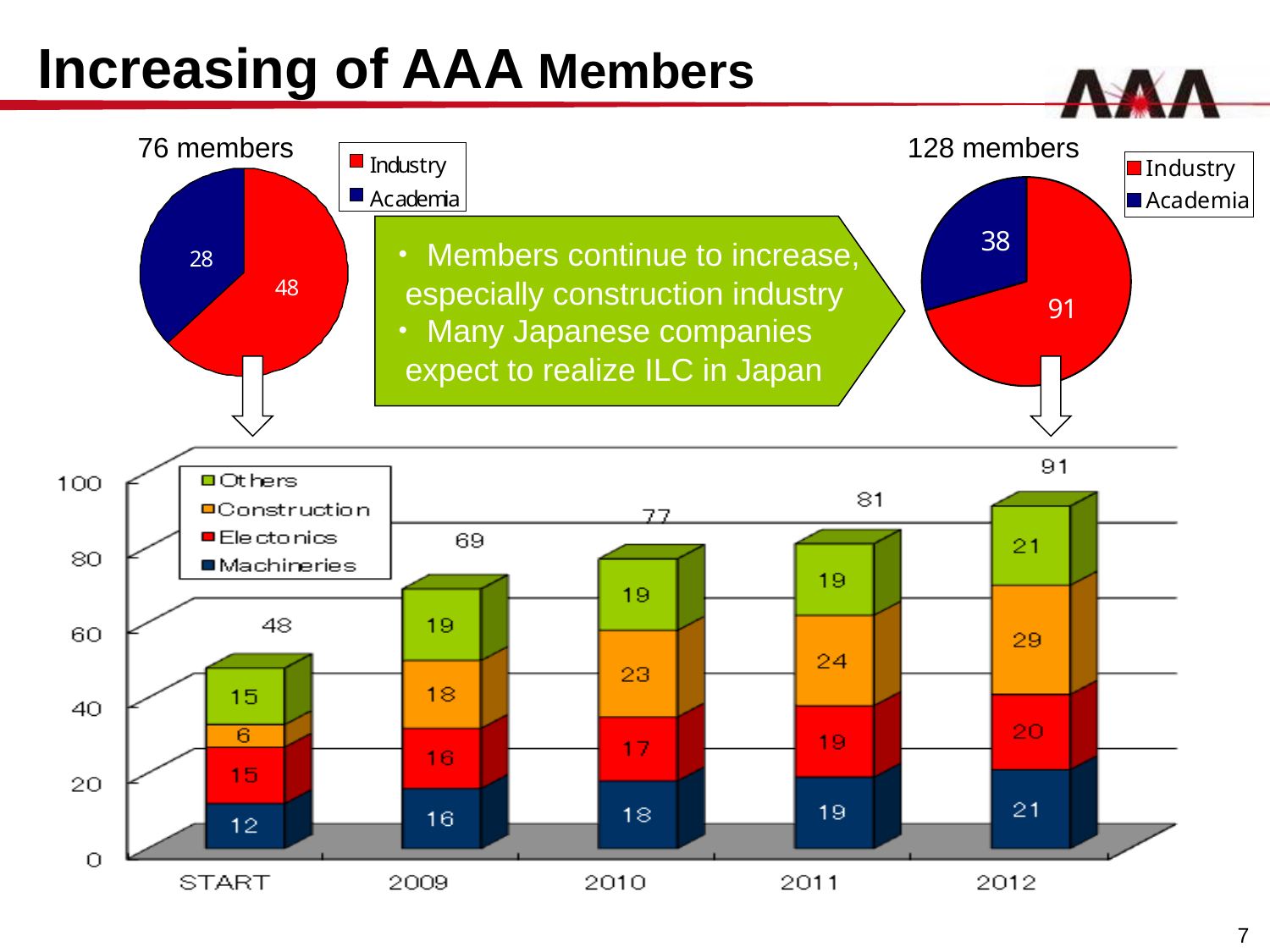
In the bottom stacked bar chart, how many series does the legend list? 4 In the bottom stacked bar chart, how many categories are shown on the x axis? 5 In the bottom stacked bar chart, which year has the highest total? 2012 In the bottom stacked bar chart, what is the total for 2012? 91 In the bottom stacked bar chart, do the totals rise or fall from START to 2012? rise In the '128 members' pie chart on the right, what is the value for Industry? 91 In the bottom stacked bar chart, what is the difference between the Construction values for 2012 and START? 23 In the bottom stacked bar chart, what is the Construction value for 2011? 24 In the '128 members' pie chart on the right, which is larger, Industry or Academia? Industry In the bottom stacked bar chart, which category has the lowest total? START In the bottom stacked bar chart, what is the Machineries value for START? 12 In the '76 members' pie chart on the left, what is the value for Academia? 28